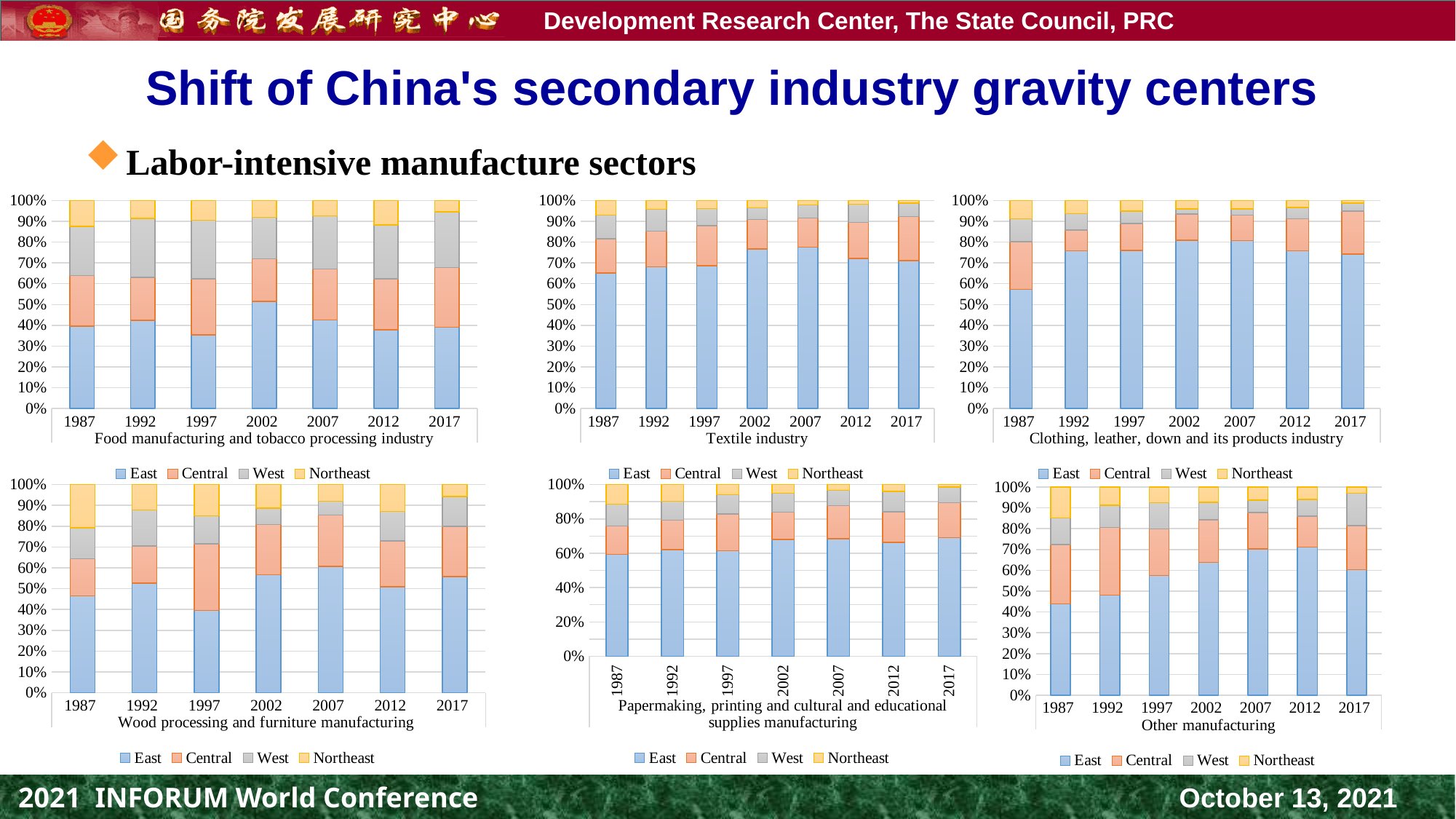
How many series does the legend of the 'Wood processing and furniture manufacturing' chart list? 4 In the 'Wood processing and furniture manufacturing' chart, is the East share in 1997 greater or less than 50%? less Which series is shown in blue at the bottom of each stacked bar in the 'Textile industry' chart? East What kind of chart is the 'Textile industry' chart? Stacked bar chart In the 'Papermaking, printing and cultural and educational supplies manufacturing' chart, is the East share in 2002 greater or less than 60%? greater In the 'Textile industry' chart, is the East share in 2007 greater or less than 70%? greater In the 'Other manufacturing' chart, which year has the lowest East share? 1987 In the 'Clothing, leather, down and its products industry' chart, which year has the larger East share, 1987 or 2002? 2002 How many years are shown on the x axis of the 'Food manufacturing and tobacco processing industry' chart? 7 In the 'Wood processing and furniture manufacturing' chart, which year has the lowest East share? 1997